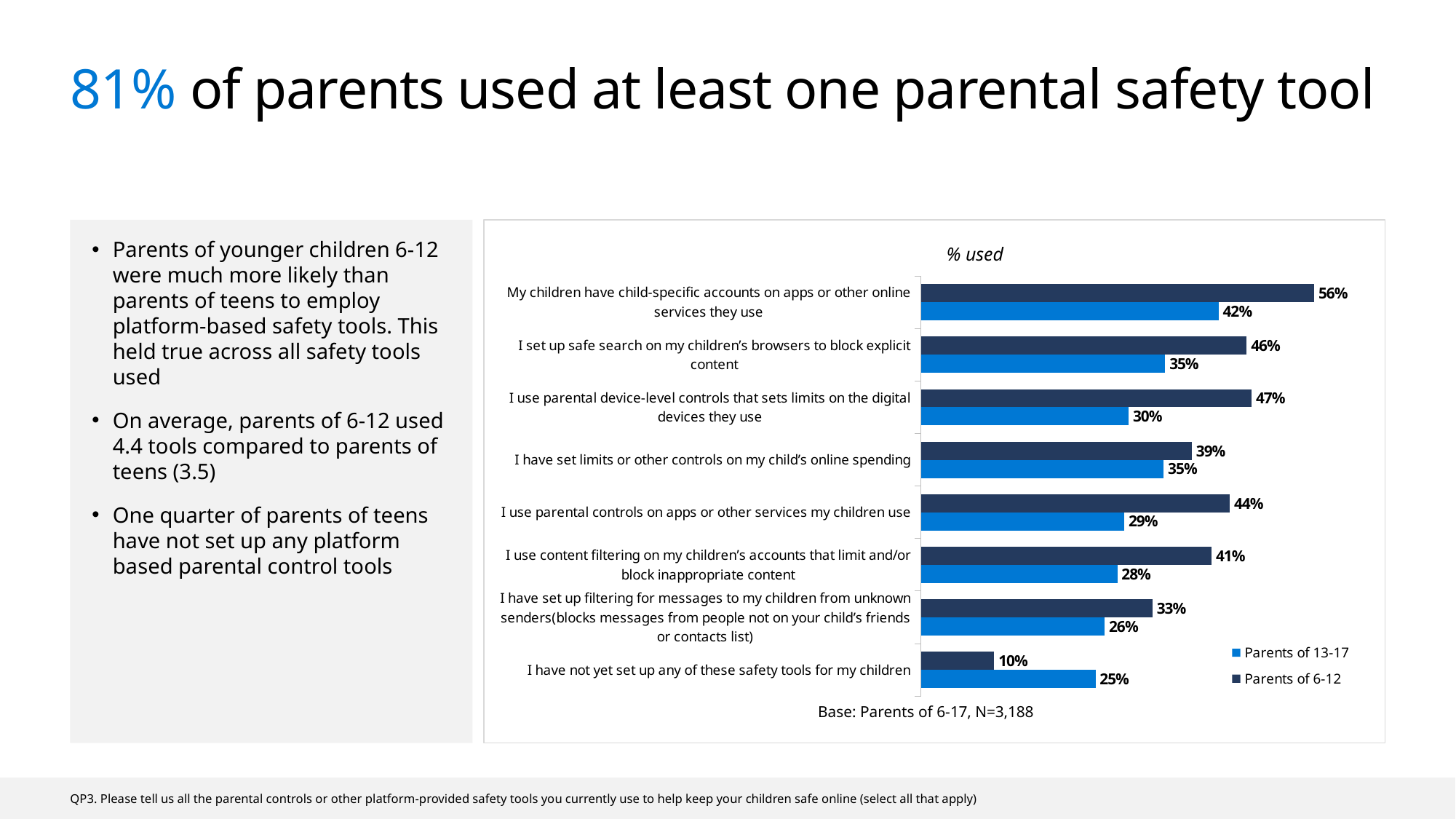
What percentage of parents of 13-17 said they use parental device-level controls that set limits on the digital devices their children use? 30% Which safety tool has the highest value for parents of 6-12? My children have child-specific accounts on apps or other online services they use What is the difference between parents of 6-12 and parents of 13-17 for having set limits or other controls on their child's online spending? 4 percentage points What is the base (sample size) noted below the chart? Parents of 6-17, N=3,188 Which category has the lowest value for parents of 6-12? I have not yet set up any of these safety tools for my children What is the difference between parents of 6-12 and parents of 13-17 for using parental device-level controls? 17 percentage points For setting up safe search on children's browsers, which group has the higher value: parents of 6-12 or parents of 13-17? Parents of 6-12 What percentage of parents of 13-17 have not yet set up any of these safety tools for their children? 25% What percentage of parents of 6-12 said their children have child-specific accounts on apps or other online services they use? 56% What type of chart is shown on the slide? Bar chart How many safety tool categories are shown in the chart? 8 How many series does the chart legend list? 2